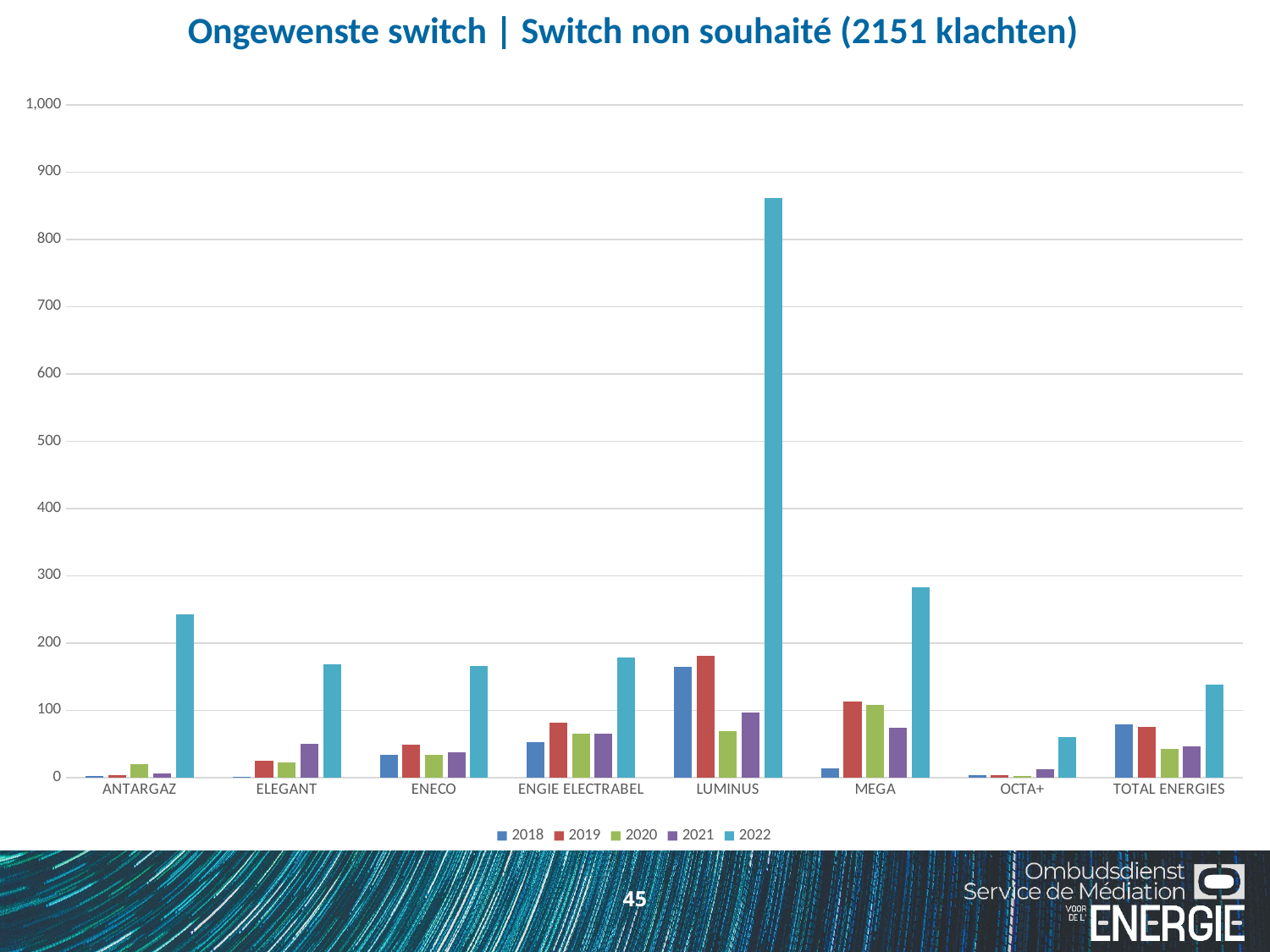
Is the 2022 value for ANTARGAZ greater or less than 200? greater Which is larger: the 2022 value for LUMINUS or the 2022 value for MEGA? LUMINUS Is the 2022 value for OCTA+ greater or less than 100? less Is the 2022 value for LUMINUS greater or less than 800? greater Which supplier has the lowest bar for 2022? OCTA+ What kind of chart is shown on the slide? bar chart How many suppliers are shown on the x axis? 8 What is the title of the chart? Ongewenste switch | Switch non souhaité (2151 klachten) How many series does the legend list? 5 For LUMINUS, which year has the larger value: 2019 or 2020? 2019 Which supplier has the highest bar for 2022? LUMINUS